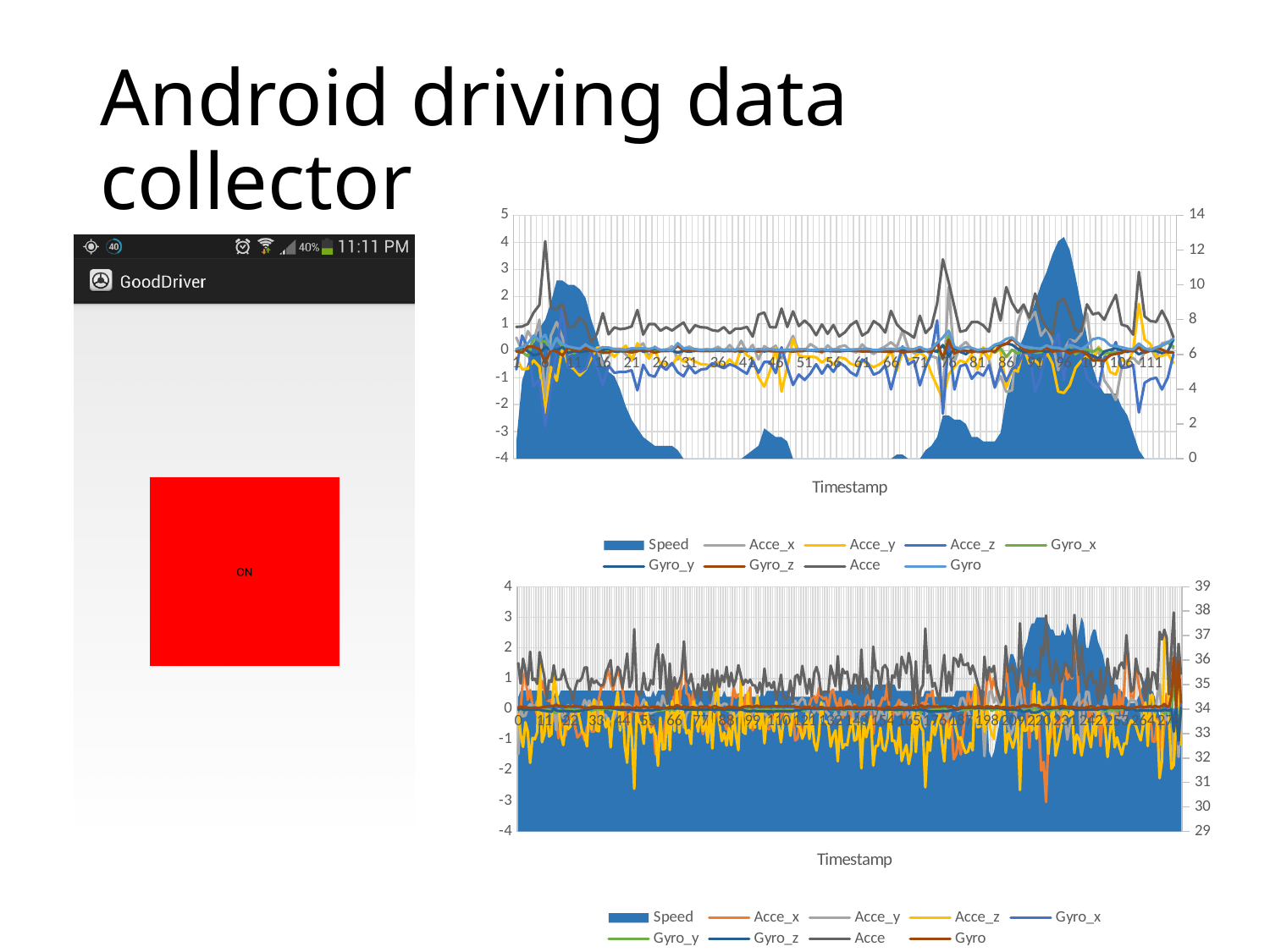
In the top chart, is the Speed value at timestamp 51 greater or less than 4 on the right-hand axis? less How many series does the legend of the bottom chart list? 9 In the bottom chart, is the Speed value at timestamp 99 greater or less than 32 on the right-hand axis? greater In the bottom chart, is the peak Speed value near timestamp 220 greater or less than 36 on the right-hand axis? greater How many series does the legend of the top chart list? 9 What is the x-axis title of the top chart? Timestamp In the top chart, which series is drawn as a filled area rather than a line? Speed What is the lowest value shown on the right-hand axis of the bottom chart? 29 What is the highest value shown on the right-hand axis of the top chart? 14